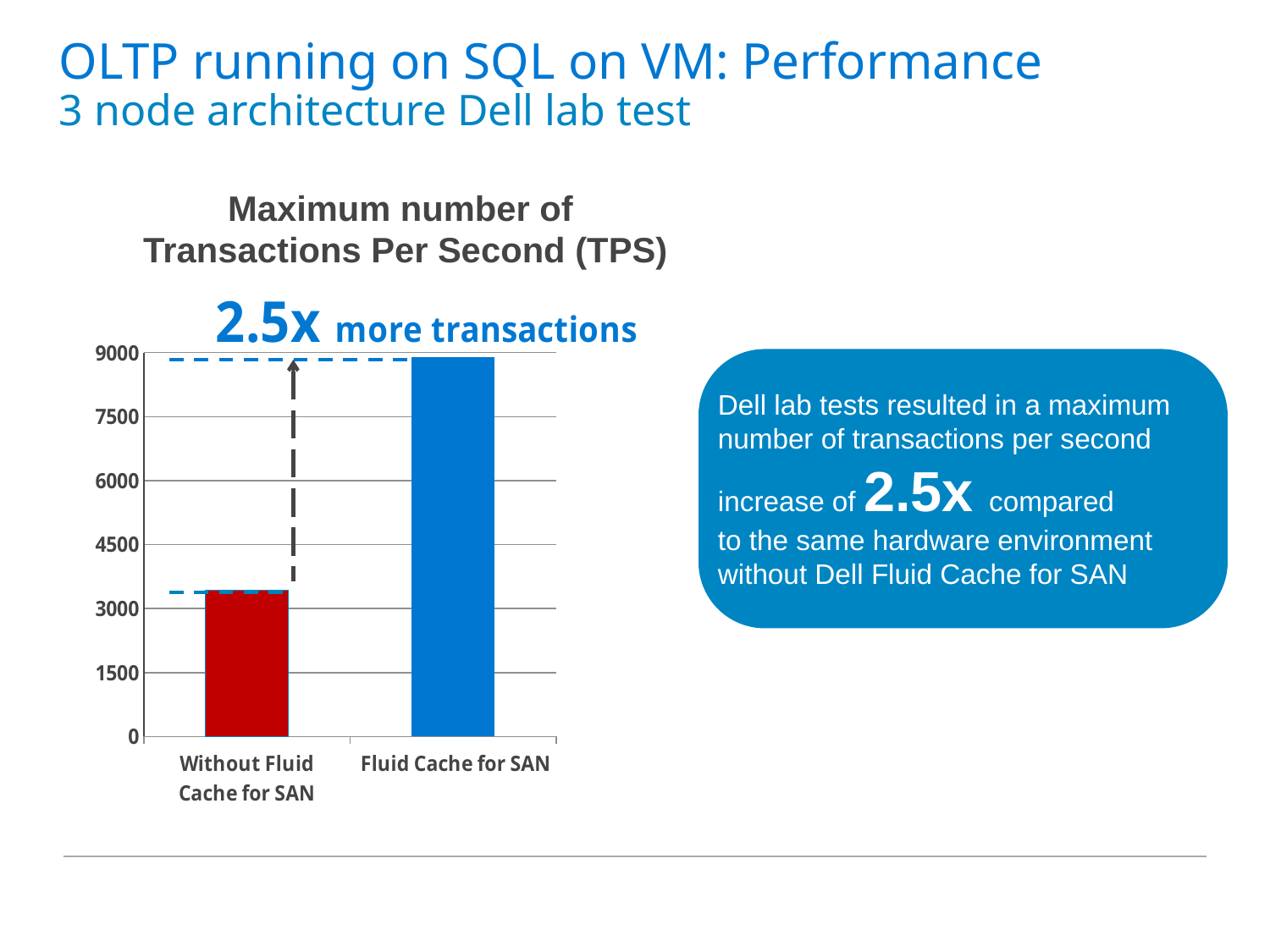
Is the value for Without Fluid Cache for SAN greater or less than 3000? greater According to the annotation on the chart, how many times more transactions does Fluid Cache for SAN deliver? 2.5x Is the value for Without Fluid Cache for SAN greater or less than 4500? less What kind of chart is shown on the slide? bar chart What is the highest value shown on the vertical axis of the chart? 9000 What is the title of the chart? Maximum number of Transactions Per Second (TPS) How many categories (bars) does the chart show? 2 Is the value for Fluid Cache for SAN greater or less than 6000? greater Which category has the highest value? Fluid Cache for SAN Which is larger: the value for Without Fluid Cache for SAN or the value for Fluid Cache for SAN? Fluid Cache for SAN Which category has the lowest value? Without Fluid Cache for SAN